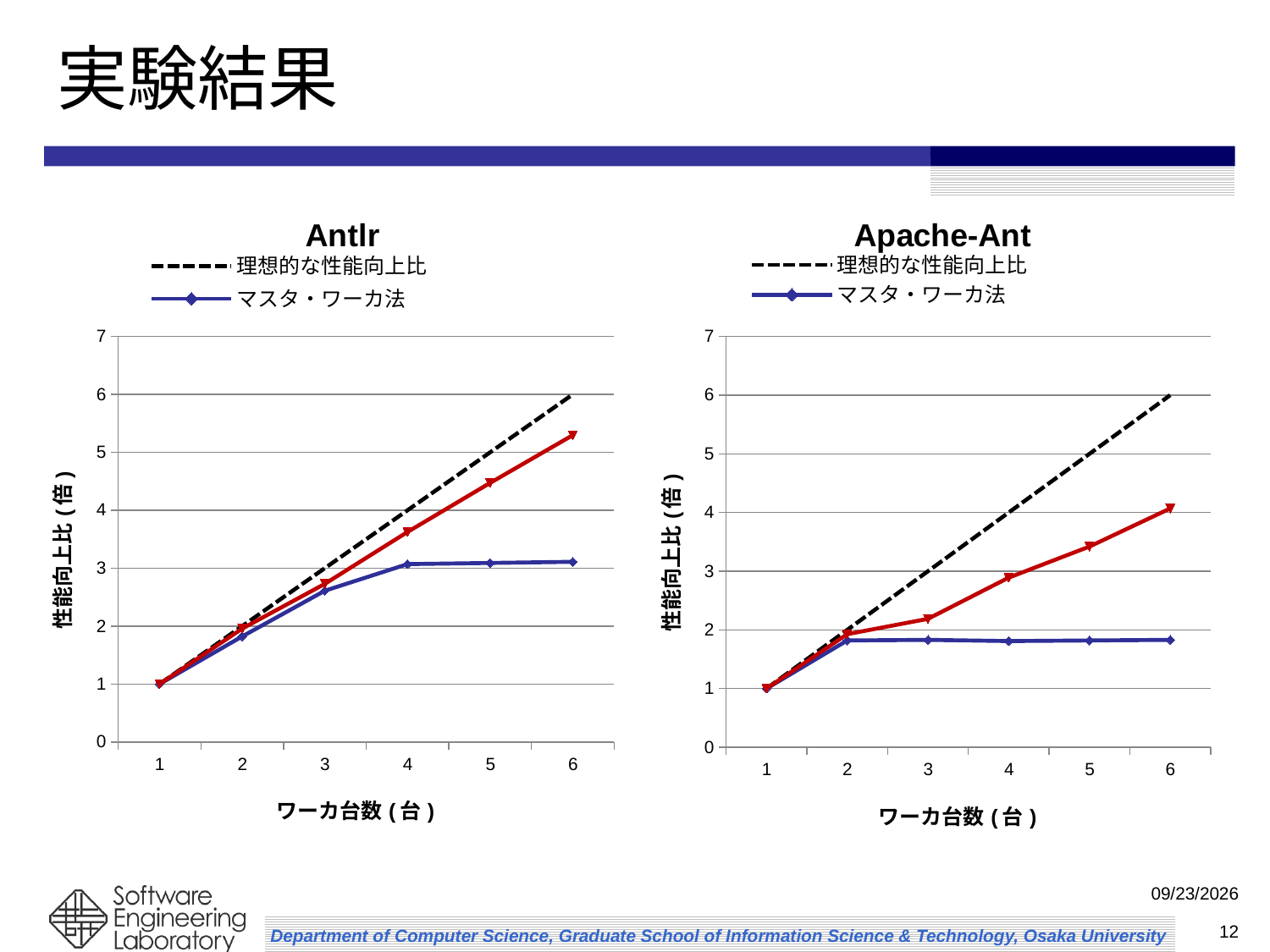
In the Antlr chart, is the value of マスタ・ワーカ法 at 6 workers greater or less than 4? less In the Antlr chart, what is the value of 理想的な性能向上比 at 6 workers? 6 In the Apache-Ant chart, which series has the lowest value at 6 workers? マスタ・ワーカ法 In the Antlr chart, is the value of マスタ・ワーカ法 at 4 workers greater or less than 2? greater How many worker counts (x-axis points) are plotted in the Antlr chart? 6 What kind of chart is the Antlr chart? line chart What is the title of the chart on the right side of the slide? Apache-Ant How many series does the legend of the Apache-Ant chart list? 2 In the Apache-Ant chart, does the 理想的な性能向上比 line rise or fall as the number of workers increases? rise In the Apache-Ant chart, is the value of マスタ・ワーカ法 at 6 workers greater or less than 2? less In the Antlr chart, which series has the highest value at 6 workers? 理想的な性能向上比 At 6 workers, is the マスタ・ワーカ法 value larger in the Antlr chart or in the Apache-Ant chart? Antlr